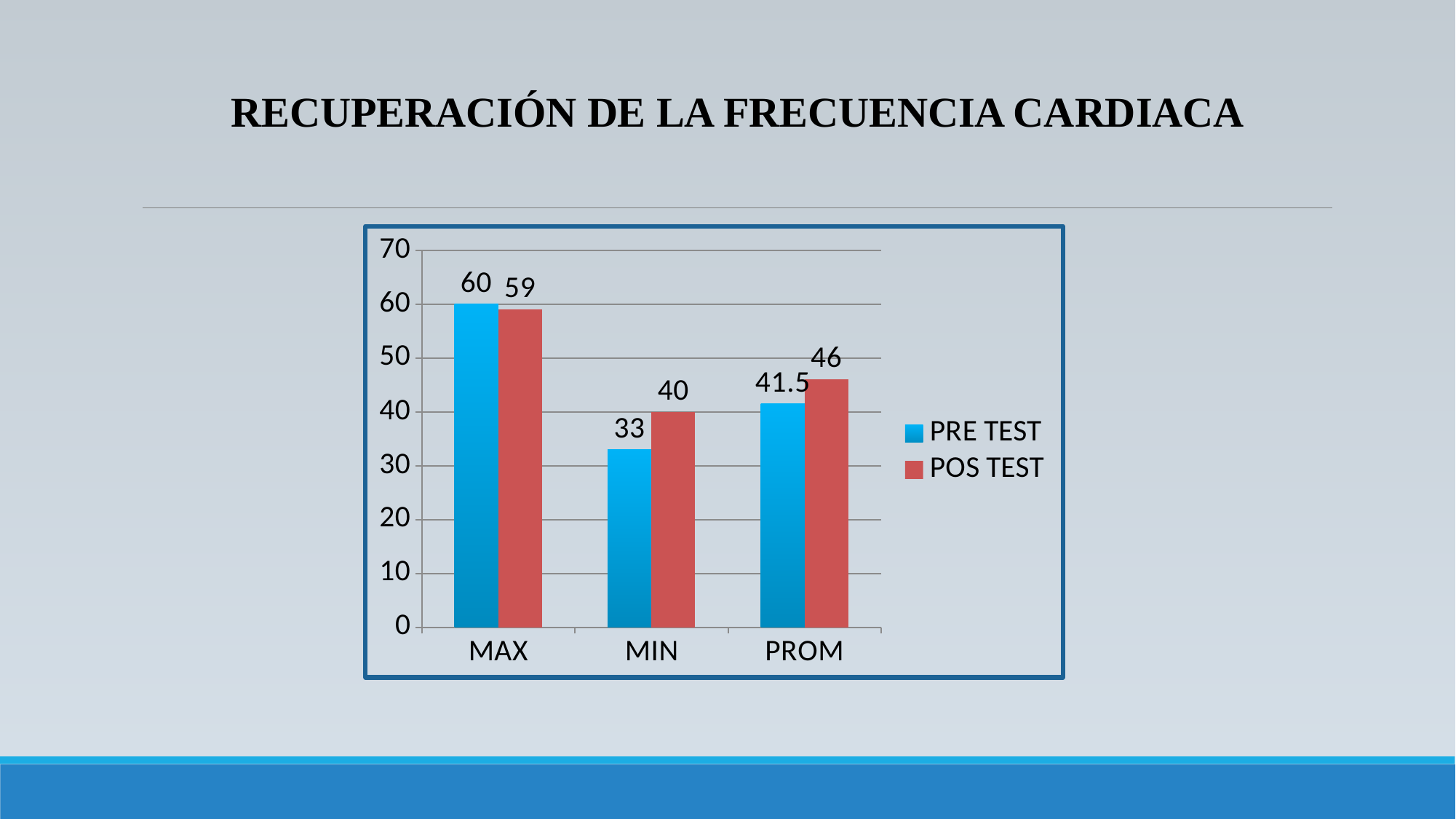
What is the difference between the PRE TEST and POS TEST values for MAX? 1 What is the POS TEST value for PROM? 46 For PROM, which series has the larger value, PRE TEST or POS TEST? POS TEST How many series does the legend list? 2 What is the difference between the POS TEST and PRE TEST values for MIN? 7 What is the POS TEST value for MIN? 40 Which category has the lowest PRE TEST value? MIN What is the PRE TEST value for MAX? 60 How many categories are shown on the x axis? 3 What kind of chart is shown on the slide? Bar chart What is the PRE TEST value for PROM? 41.5 Which category has the highest POS TEST value? MAX